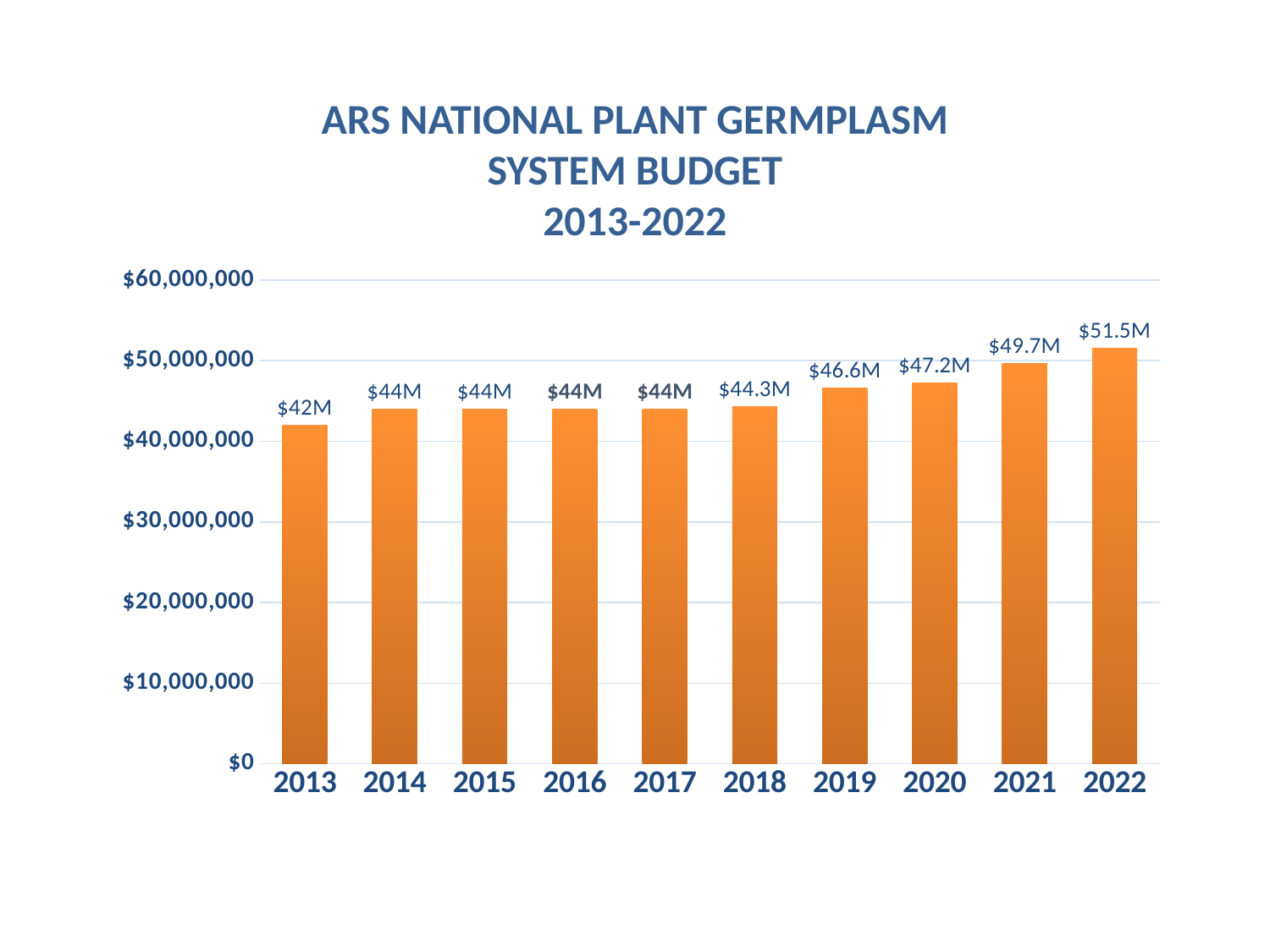
What kind of chart is this? Bar chart Which year has a larger budget, 2018 or 2020? 2020 What is the budget value shown for 2013? $42M What is the difference between the 2022 budget and the 2021 budget? $1.8M What is the budget value shown for 2022? $51.5M Which year has the lowest budget? 2013 What is the budget value shown for 2019? $46.6M Which year has the highest budget? 2022 What is the title of the chart? ARS National Plant Germplasm System Budget 2013-2022 Is the value for 2021 greater or less than $40,000,000? greater Do the budget values generally rise or fall from 2013 to 2022? Rise How many years are shown on the x axis? 10